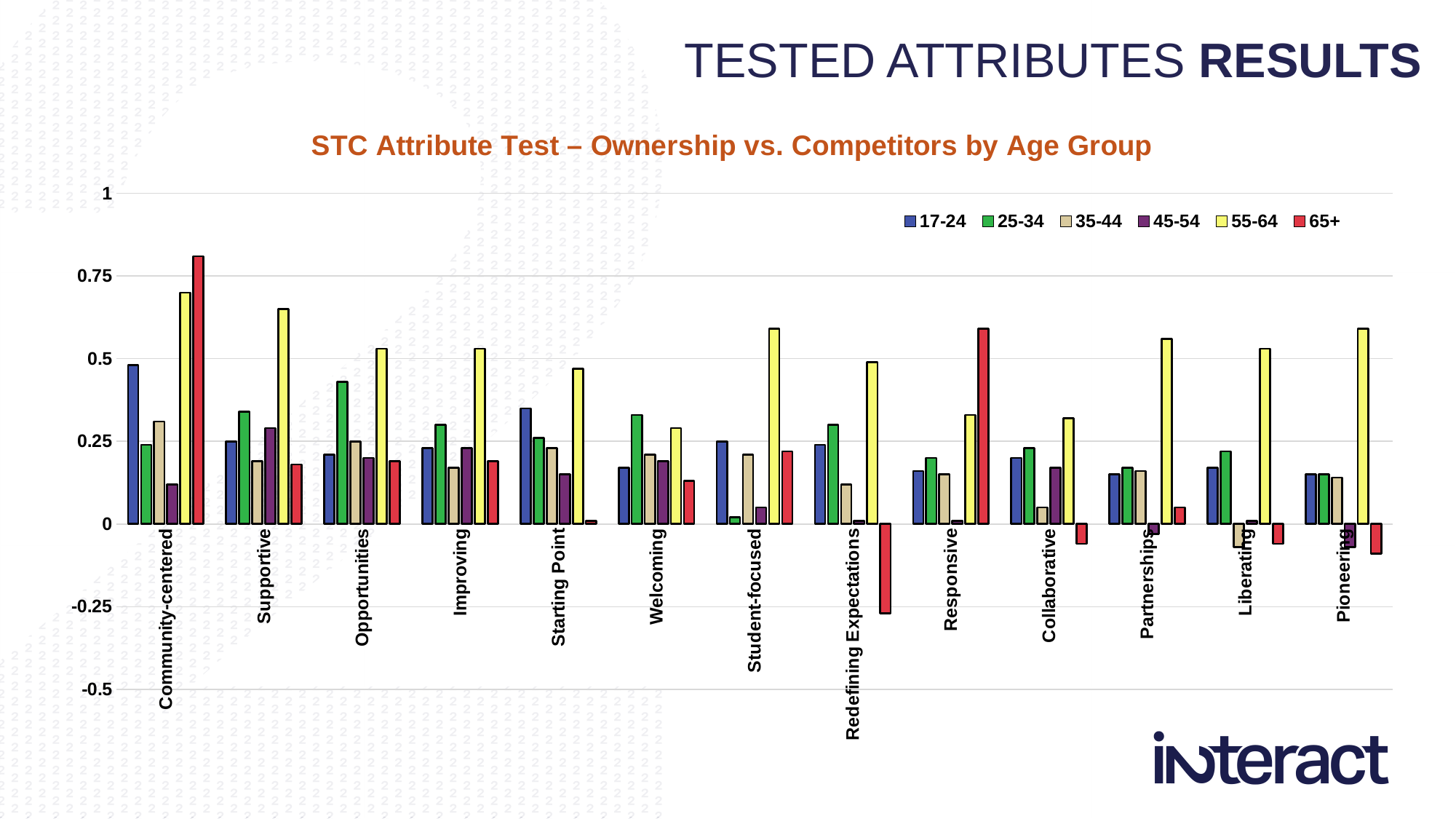
Which age group has the highest value for Pioneering? 55-64 How many age-group series does the legend list? 6 Is the value for the 45-54 group on Community-centered greater or less than 0.25? less Which attribute and age group has the lowest bar in the chart? Redefining Expectations, 65+ How many attribute categories are shown along the x axis? 13 Is the value for the 65+ group on Community-centered greater or less than 0.75? greater Is the value for the 55-64 group on Supportive greater or less than 0.5? greater For Welcoming, which is larger: the 25-34 value or the 65+ value? 25-34 What is the title of the chart? STC Attribute Test – Ownership vs. Competitors by Age Group What kind of chart is shown on the slide? Bar chart Which attribute and age group has the highest bar in the chart? Community-centered, 65+